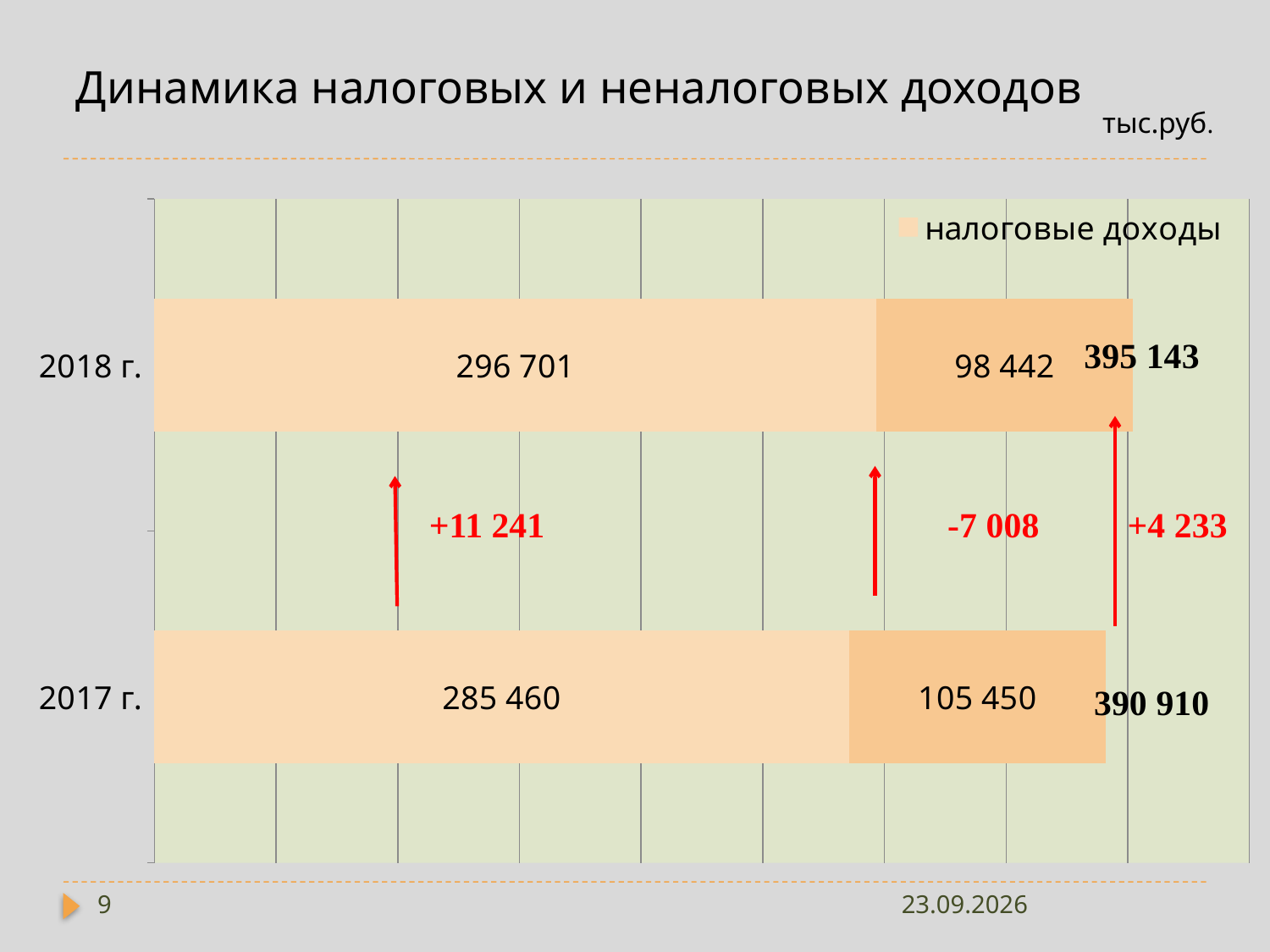
By how much did the darker orange segment change from 2017 г. to 2018 г.? -7 008 What is the value of the darker orange segment for 2018 г.? 98 442 What is the value of the darker orange segment for 2017 г.? 105 450 What kind of chart is shown on the slide? Stacked bar chart What is the value of налоговые доходы for 2017 г.? 285 460 What is the total of the stacked bar for 2018 г.? 395 143 What unit is stated for the chart values? тыс.руб. How many categories (years) are shown on the chart? 2 What is the total of the stacked bar for 2017 г.? 390 910 Which year has the larger total, 2017 г. or 2018 г.? 2018 г. What is the value of налоговые доходы for 2018 г.? 296 701 By how much did налоговые доходы change from 2017 г. to 2018 г.? +11 241